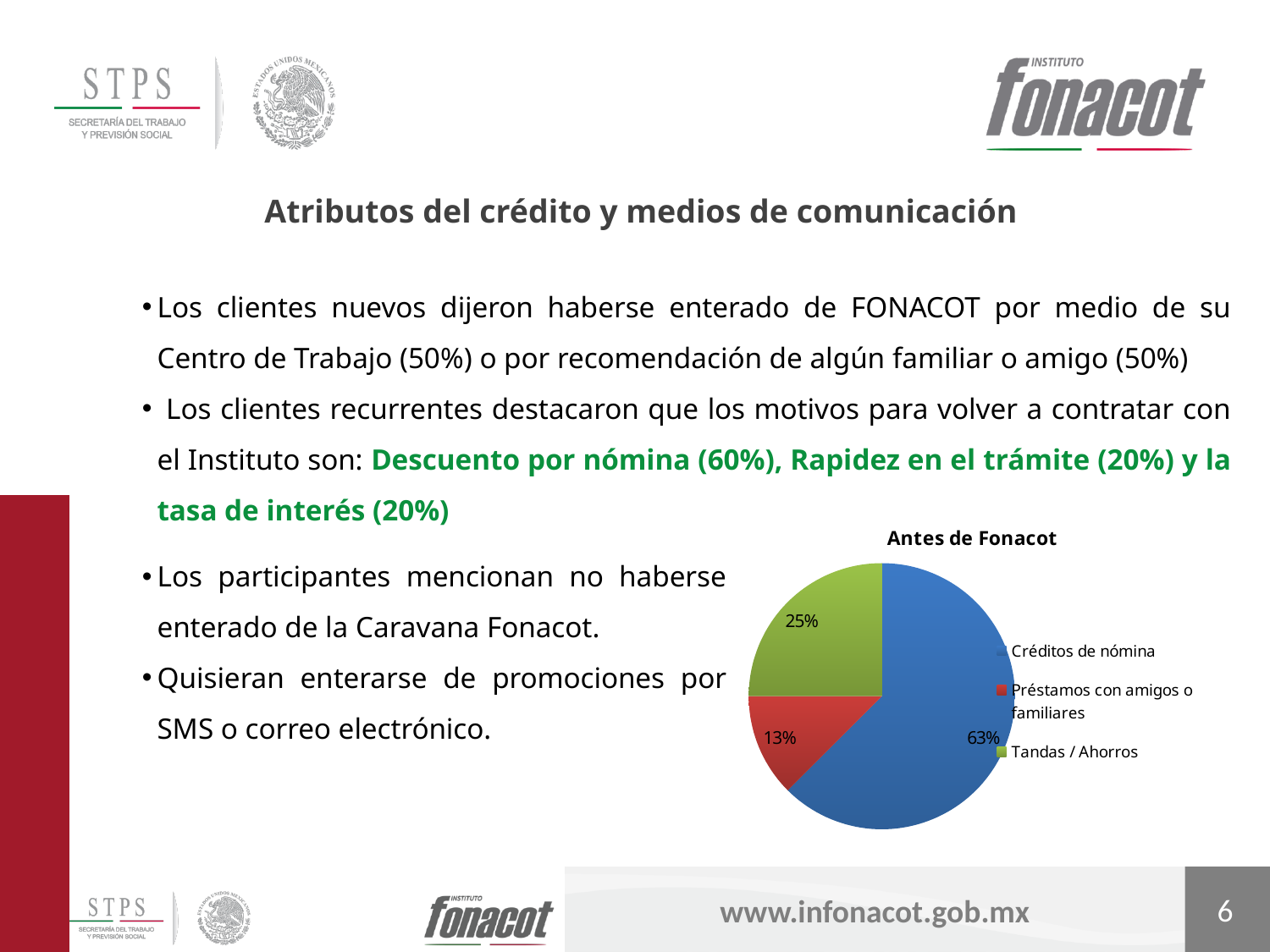
What share of the pie does Créditos de nómina represent? 63% Which category has the largest slice of the pie? Créditos de nómina What kind of chart is shown on the slide? pie chart Which is larger, the slice for Tandas / Ahorros or the slice for Préstamos con amigos o familiares? Tandas / Ahorros What is the difference in percentage points between Tandas / Ahorros and Préstamos con amigos o familiares? 12 What colour is the slice for Créditos de nómina? blue What share of the pie does Préstamos con amigos o familiares represent? 13% Which category has the smallest slice of the pie? Préstamos con amigos o familiares How many categories does the pie chart show? 3 What is the title of the chart? Antes de Fonacot What share of the pie does Tandas / Ahorros represent? 25% What is the difference in percentage points between Créditos de nómina and Tandas / Ahorros? 38